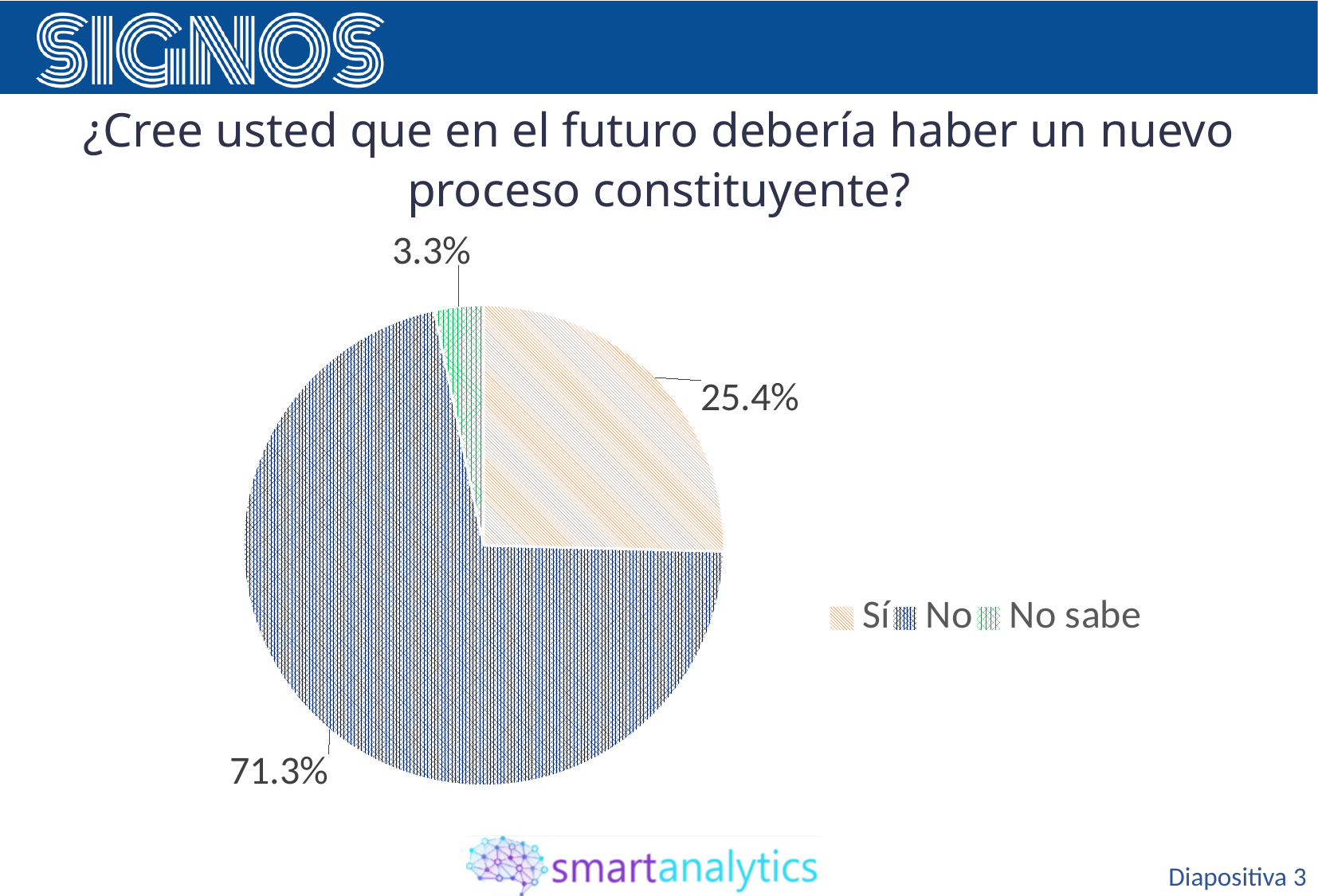
What percentage of respondents answered "No sabe"? 3.3% Which response has the largest share of the pie? No What percentage of respondents answered "No"? 71.3% What is the difference in percentage points between "Sí" and "No sabe"? 22.1 What question is shown as the title above the chart? ¿Cree usted que en el futuro debería haber un nuevo proceso constituyente? What is the difference in percentage points between "No" and "Sí"? 45.9 Which response has the smallest share of the pie? No sabe How many slices does the pie chart have? 3 What percentage of respondents answered "Sí"? 25.4% What kind of chart is shown on the slide? pie chart How many entries does the legend list? 3 Which is larger, the share for "Sí" or the share for "No sabe"? Sí